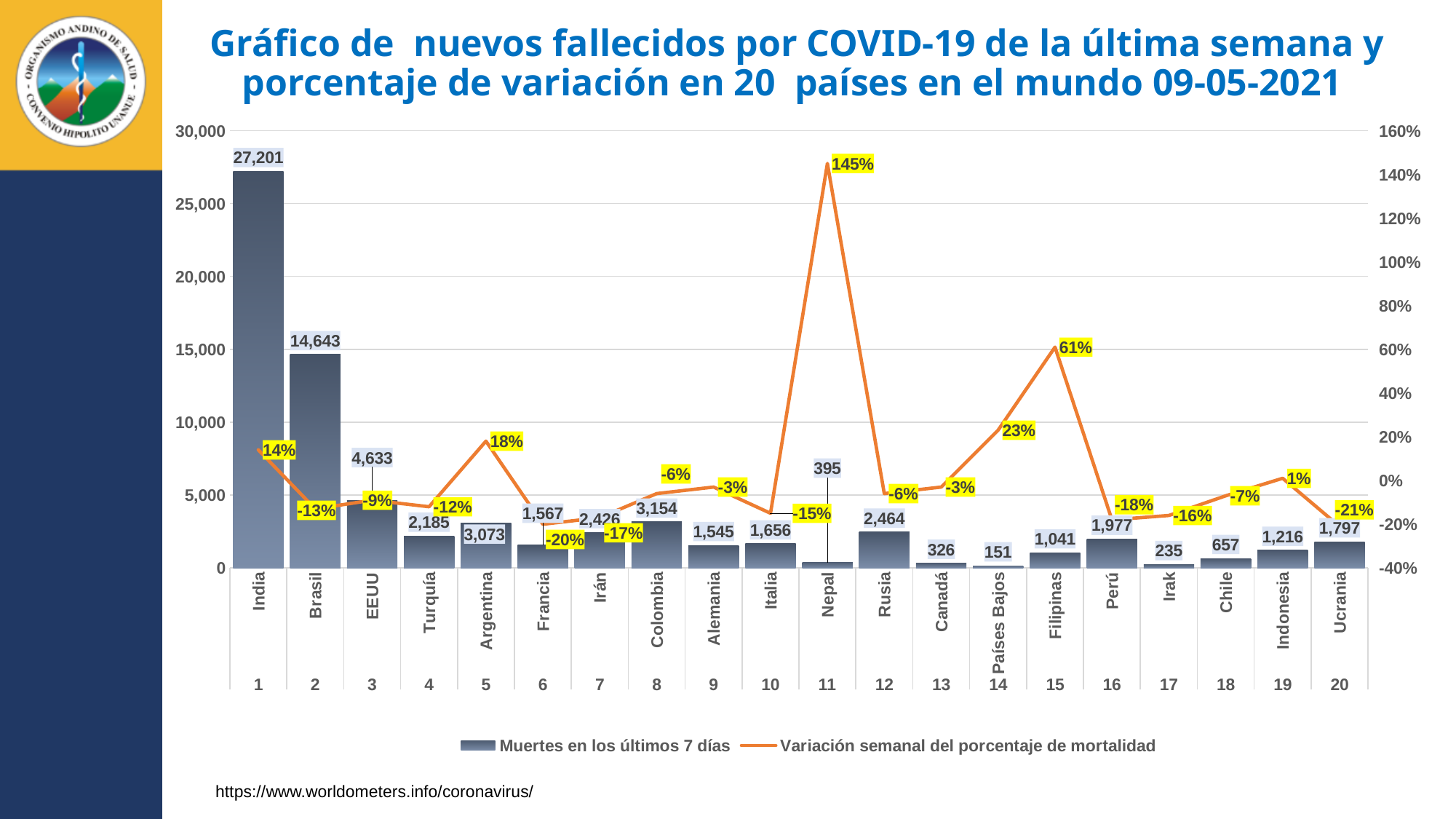
What kind of chart is this? Combined bar and line chart Is the value for deaths in the last 7 days for Brasil greater or less than 10,000? greater Which country has the highest number of deaths in the last 7 days? India What is the difference in deaths in the last 7 days between India and Brasil? 12,558 How many deaths in the last 7 days are shown for Perú? 1,977 Which has more deaths in the last 7 days, Colombia or Argentina? Colombia How many series does the legend list? 2 Which country has the lowest number of deaths in the last 7 days? Países Bajos Which country has the lowest weekly variation percentage? Ucrania How many deaths in the last 7 days are shown for India? 27,201 How many countries are shown on the chart? 20 What is the weekly variation percentage shown for Nepal? 145%